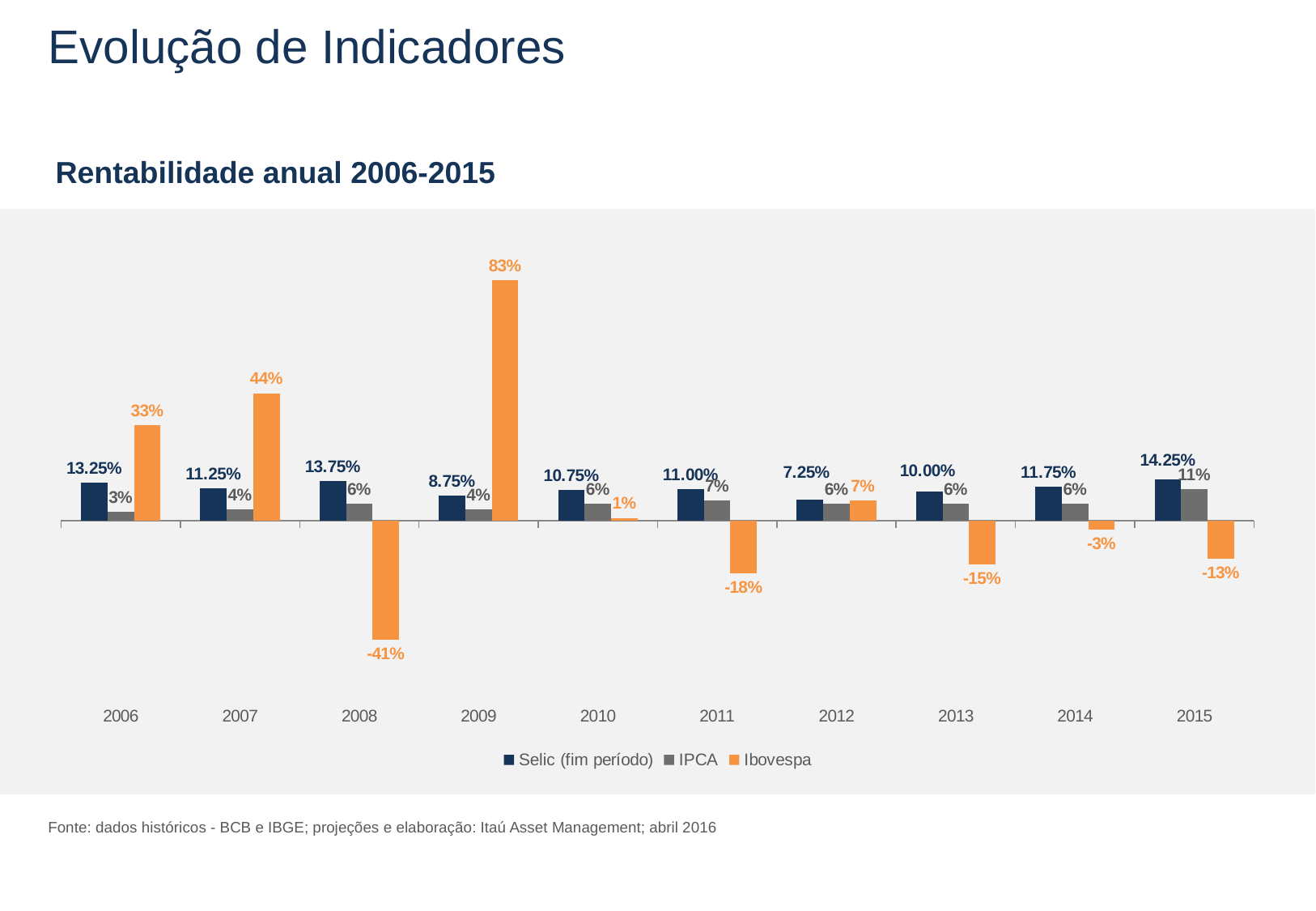
What is the difference between the Ibovespa values for 2007 and 2006? 11% What is the IPCA value for 2015? 11% What is the Ibovespa value for 2009? 83% What kind of chart is shown on the slide? Bar chart What is the Ibovespa value for 2008? -41% Which is larger, the Ibovespa value for 2010 or for 2012? 2012 What is the Selic (fim período) value for 2012? 7.25% In which year is the Ibovespa value lowest? 2008 In which year is the Ibovespa value highest? 2009 How many series does the legend list? 3 In which year is the Selic (fim período) value highest? 2015 How many years are shown on the x axis? 10